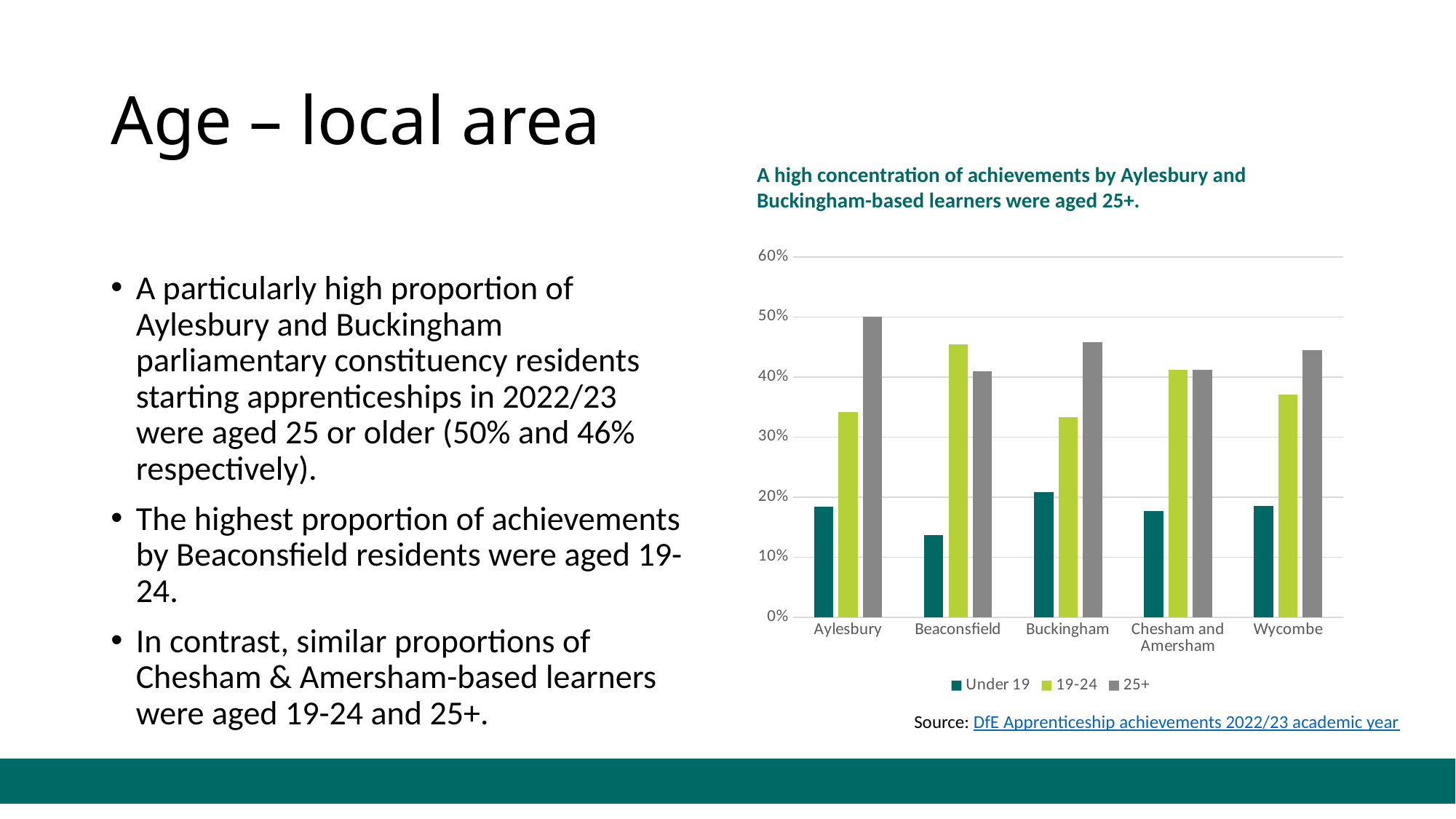
How many series does the chart legend list? 3 What is the value for the 25+ series for Aylesbury? 50% Which local area has the highest value for the 25+ series? Aylesbury What colour are the bars for the 25+ series? grey Which local area has the highest value for the 19-24 series? Beaconsfield For Beaconsfield, which is larger: the 19-24 value or the 25+ value? 19-24 Which local area has the lowest value for the Under 19 series? Beaconsfield Which local area has the lowest value for the 19-24 series? Buckingham How many local areas are shown on the x axis of the chart? 5 Is the value for the Under 19 series for Buckingham greater or less than 30%? less Is the value for the 25+ series for Wycombe greater or less than 40%? greater What kind of chart is shown on the slide? bar chart